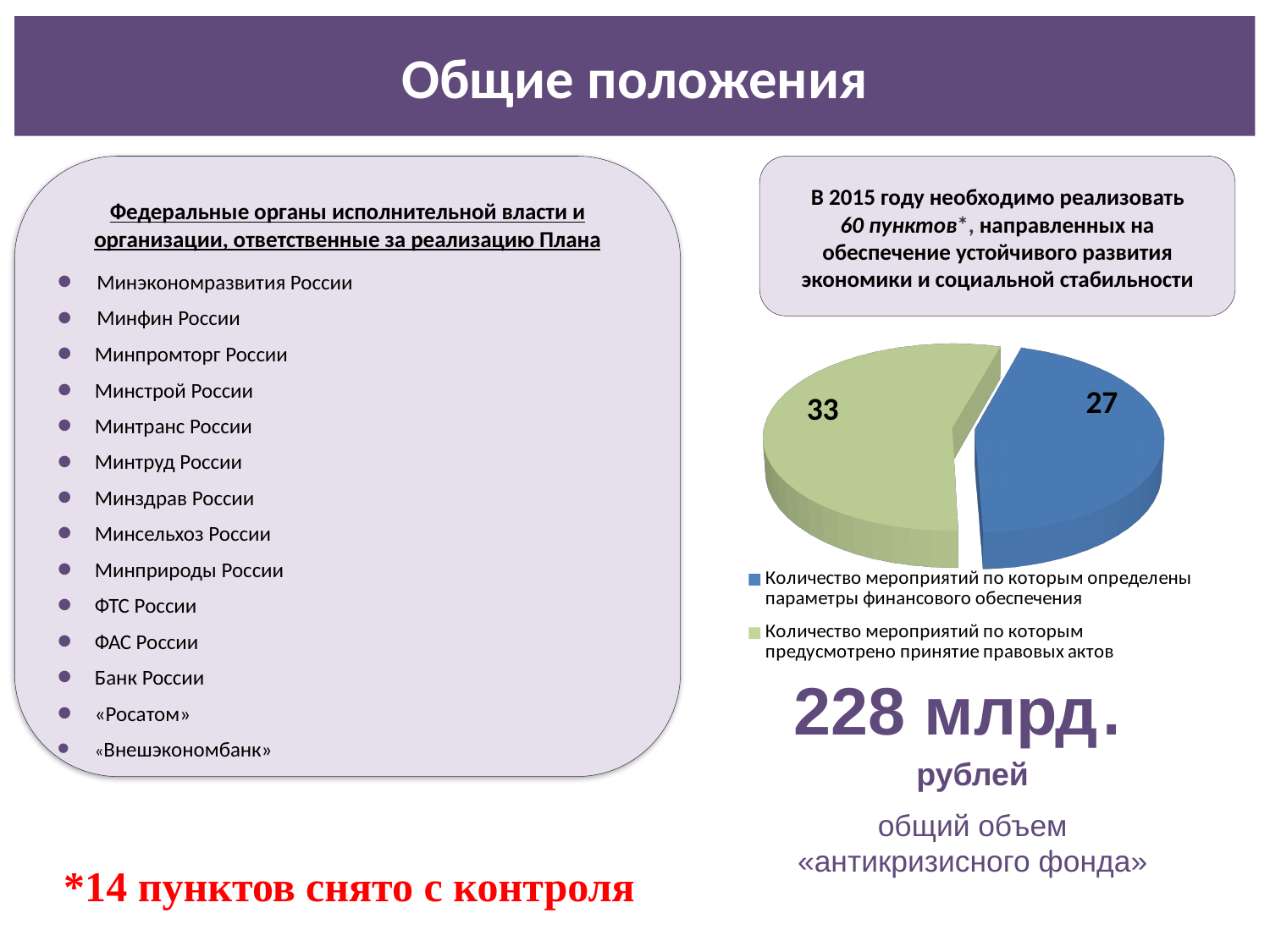
What is the total of the two slices in the pie chart? 60 Which slice of the pie chart is the largest? Количество мероприятий по которым предусмотрено принятие правовых актов Which is larger: the number of measures with defined financial parameters or the number of measures requiring legal acts? the number of measures requiring legal acts (33) What is the value for "Количество мероприятий по которым предусмотрено принятие правовых актов"? 33 What kind of chart is shown on the slide? pie chart What is the value for "Количество мероприятий по которым определены параметры финансового обеспечения"? 27 How many slices does the pie chart have? 2 What colour is the slice for "Количество мероприятий по которым определены параметры финансового обеспечения"? blue Which slice of the pie chart is the smallest? Количество мероприятий по которым определены параметры финансового обеспечения What is the difference between the two slice values in the pie chart? 6 What share of the pie does the slice with value 33 represent? 55% How many entries does the legend of the pie chart list? 2